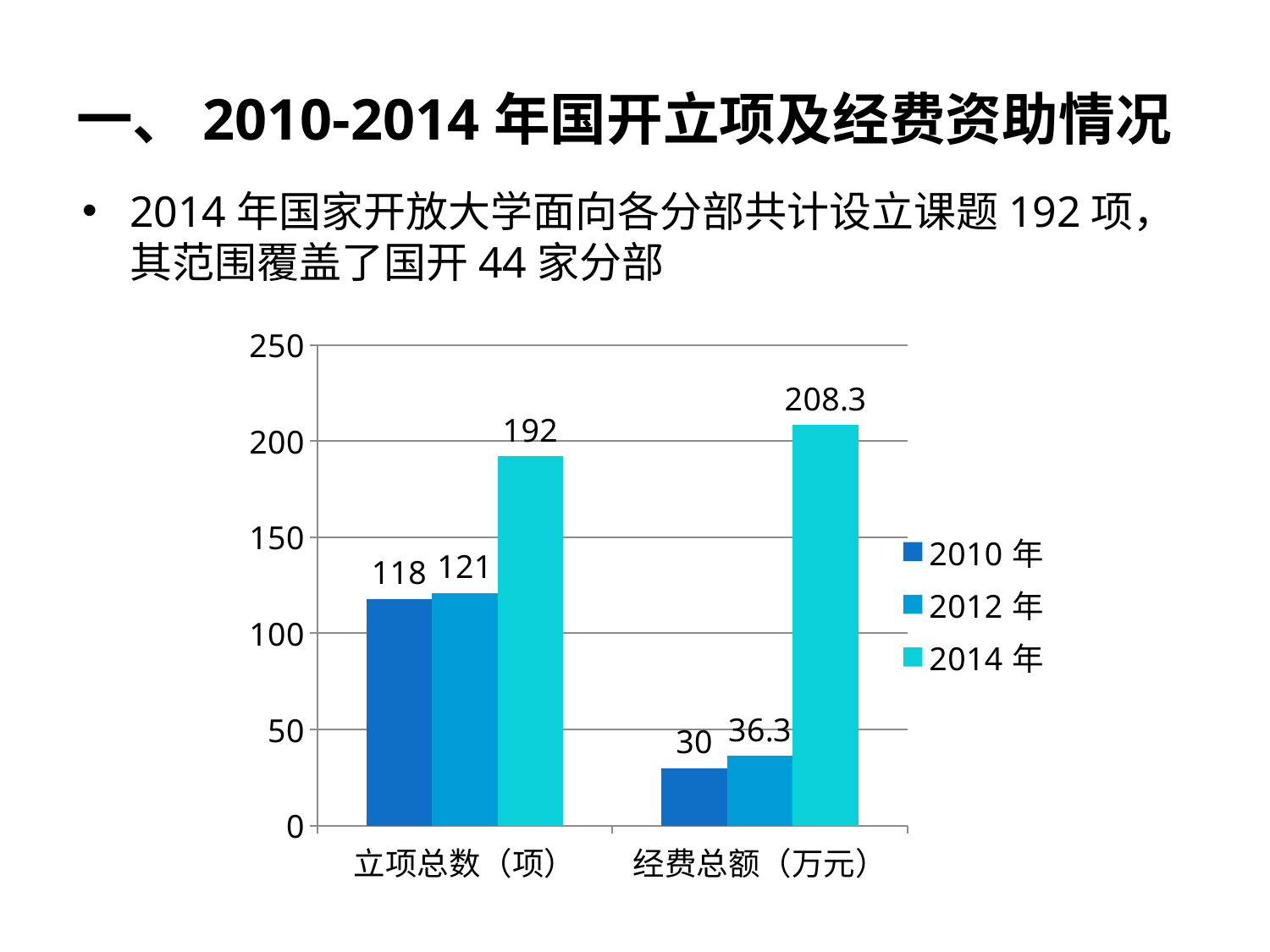
Which year has the lowest value in the 立项总数（项） category? 2010年 What is the difference between the 2014年 and 2010年 values in the 经费总额（万元） category? 178.3 What is the value for 2010年 in the 经费总额（万元） category? 30 What kind of chart is shown on the slide? Bar chart What is the value for 2014年 in the 立项总数（项） category? 192 What is the difference between the 2014年 and 2012年 values in the 立项总数（项） category? 71 What is the value for 2012年 in the 经费总额（万元） category? 36.3 Do the values for 经费总额（万元） rise or fall from 2010年 to 2014年? Rise Which year has the highest value in the 经费总额（万元） category? 2014年 How many series does the legend list? 3 Which is larger: the 2012年 value for 立项总数（项） or the 2012年 value for 经费总额（万元）? 立项总数（项） What is the value for 2010年 in the 立项总数（项） category? 118